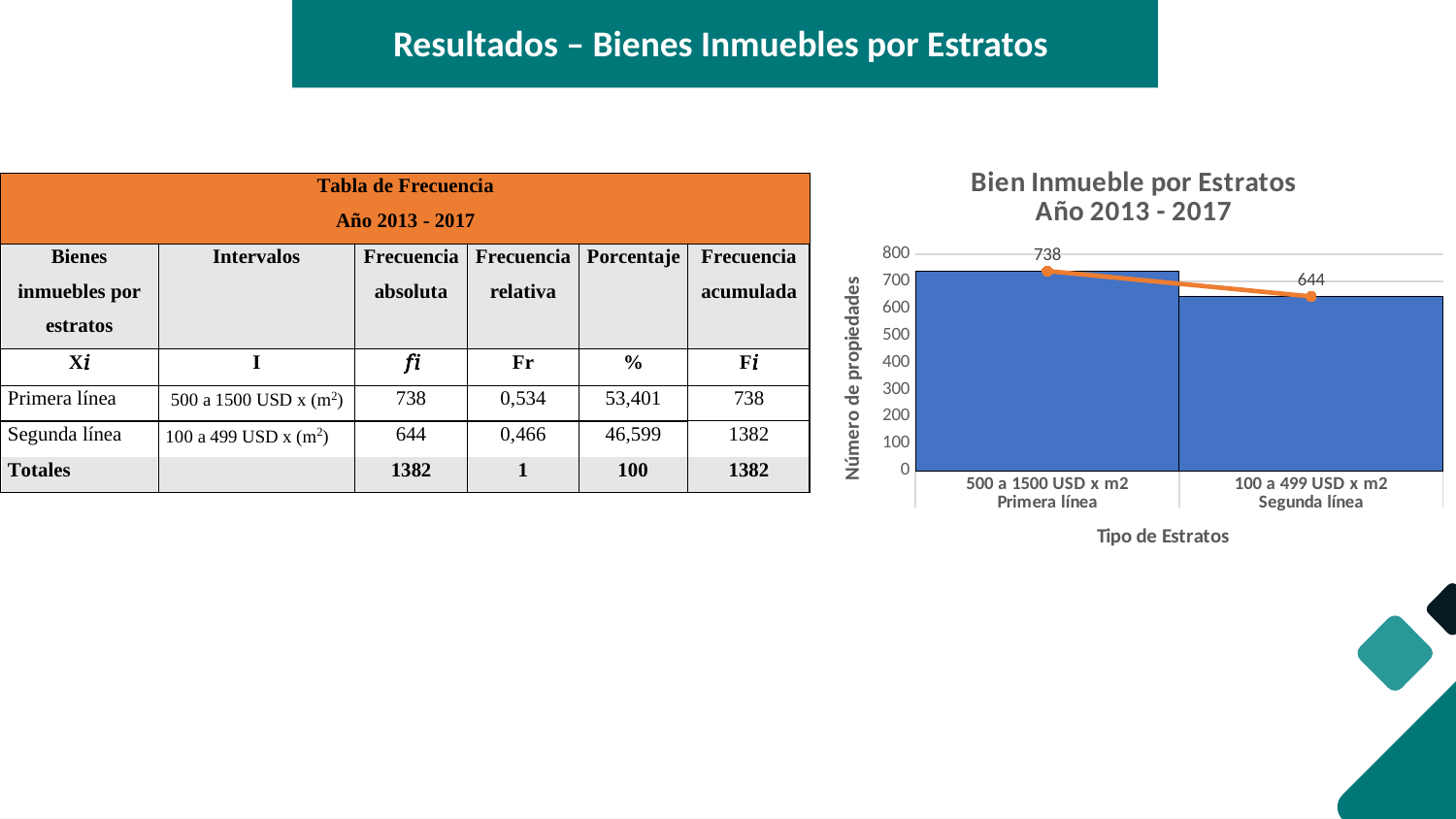
What is the difference between the values for Primera línea and Segunda línea? 94 Which category has the highest value in the chart? 500 a 1500 USD x m2 Primera línea What is the label of the y axis of the chart? Número de propiedades What kind of chart is shown on the slide? bar chart with a line overlay Which is larger, the value for Primera línea or the value for Segunda línea? Primera línea Is the value for Segunda línea greater or less than 700? less What is the value for Primera línea (500 a 1500 USD x m2) in the chart? 738 What is the title of the chart? Bien Inmueble por Estratos Año 2013 - 2017 What is the value for Segunda línea (100 a 499 USD x m2) in the chart? 644 Which category has the lowest value in the chart? 100 a 499 USD x m2 Segunda línea How many categories are shown on the x axis of the chart? 2 Do the values rise or fall from left to right along the x axis? fall